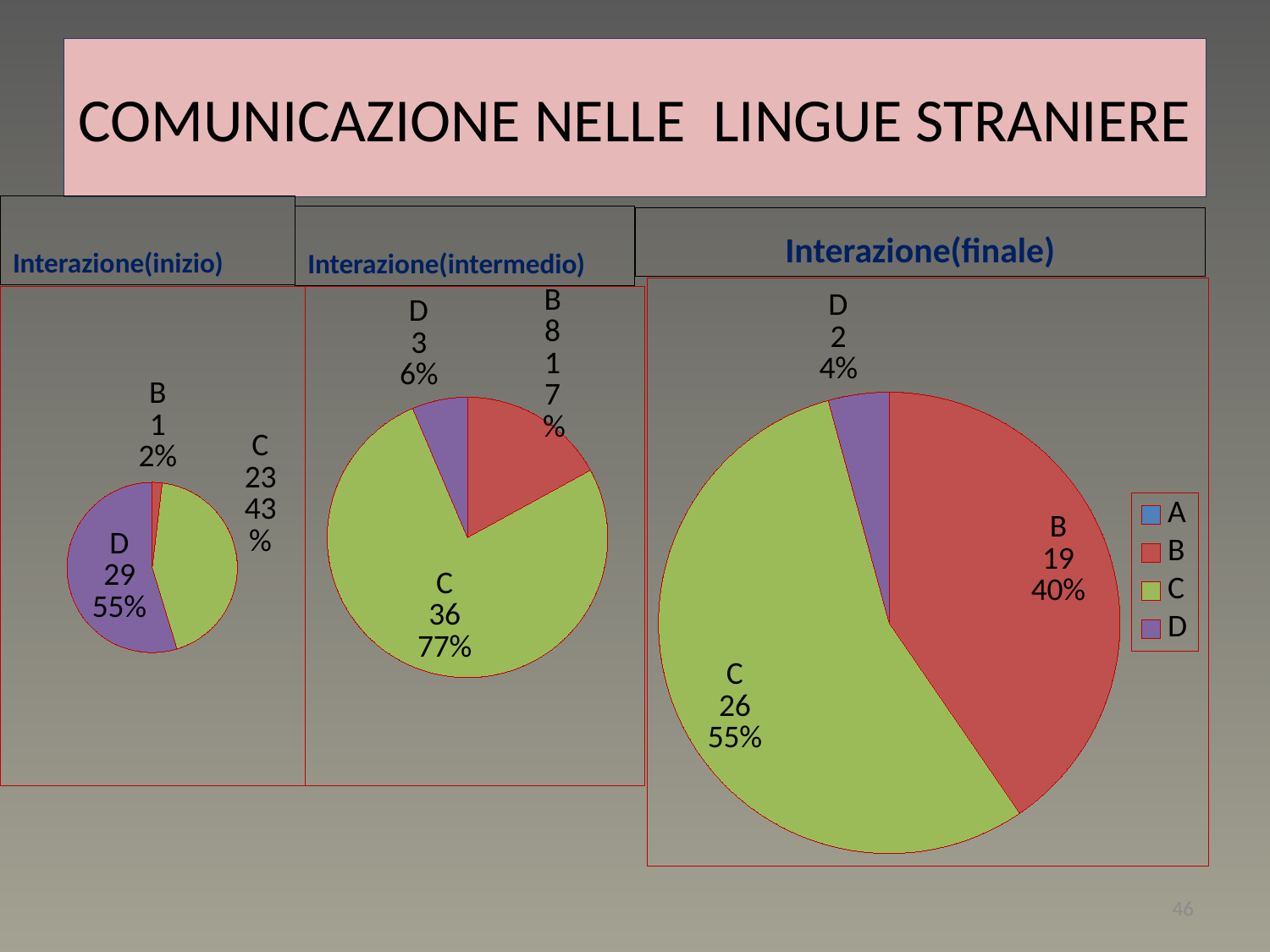
In the Interazione(intermedio) chart, which category has the largest slice? C In the Interazione(finale) chart, what share of the pie does C have? 55% In the Interazione(finale) chart, what is the value for B? 19 What kind of chart is the Interazione(finale) chart? pie chart In the Interazione(inizio) chart, what share of the pie does C have? 43% How many entries does the legend of the Interazione(finale) chart list? 4 In the Interazione(inizio) chart, which category has the smallest slice? B In the Interazione(finale) chart, which is larger, the value for B or the value for C? C In the Interazione(intermedio) chart, what share of the pie does D have? 6% In the Interazione(intermedio) chart, what is the difference between the values for C and B? 28 In the Interazione(intermedio) chart, what is the value for C? 36 In the Interazione(inizio) chart, what is the value for D? 29